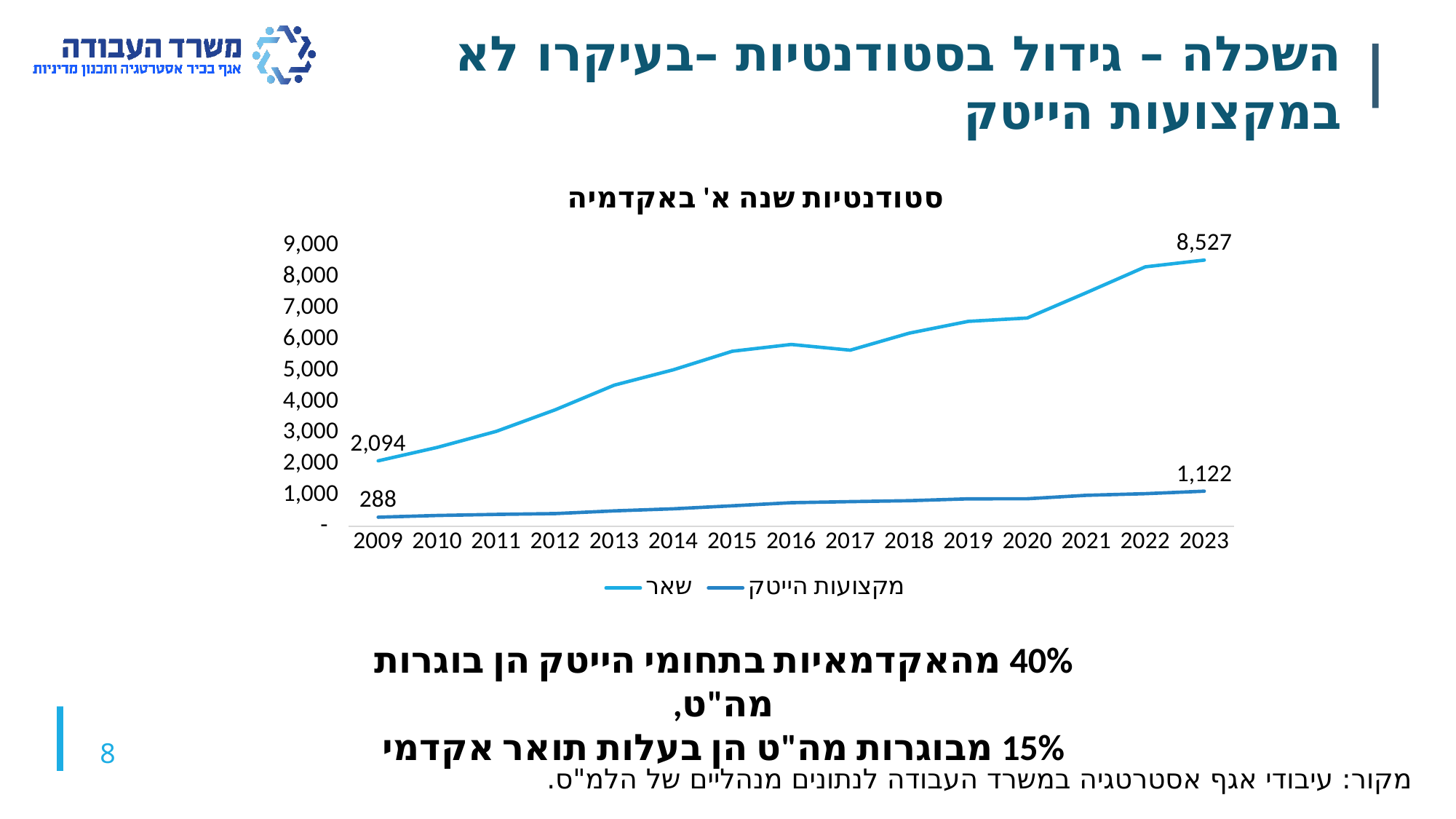
What is the value of the מקצועות הייטק series in 2009? 288 Is the value of the שאר series in 2016 greater or less than 5,000? greater What kind of chart is shown on the slide? line chart What is the value of the שאר series in 2023? 8,527 What is the title of the chart? סטודנטיות שנה א' באקדמיה What is the value of the שאר series in 2009? 2,094 How many series does the legend list? 2 Which series has the higher value in 2023, שאר or מקצועות הייטק? שאר What is the difference between the שאר and מקצועות הייטק values in 2023? 7,405 How many years are shown on the x axis? 15 What is the value of the מקצועות הייטק series in 2023? 1,122 What is the difference between the שאר value in 2023 and in 2009? 6,433